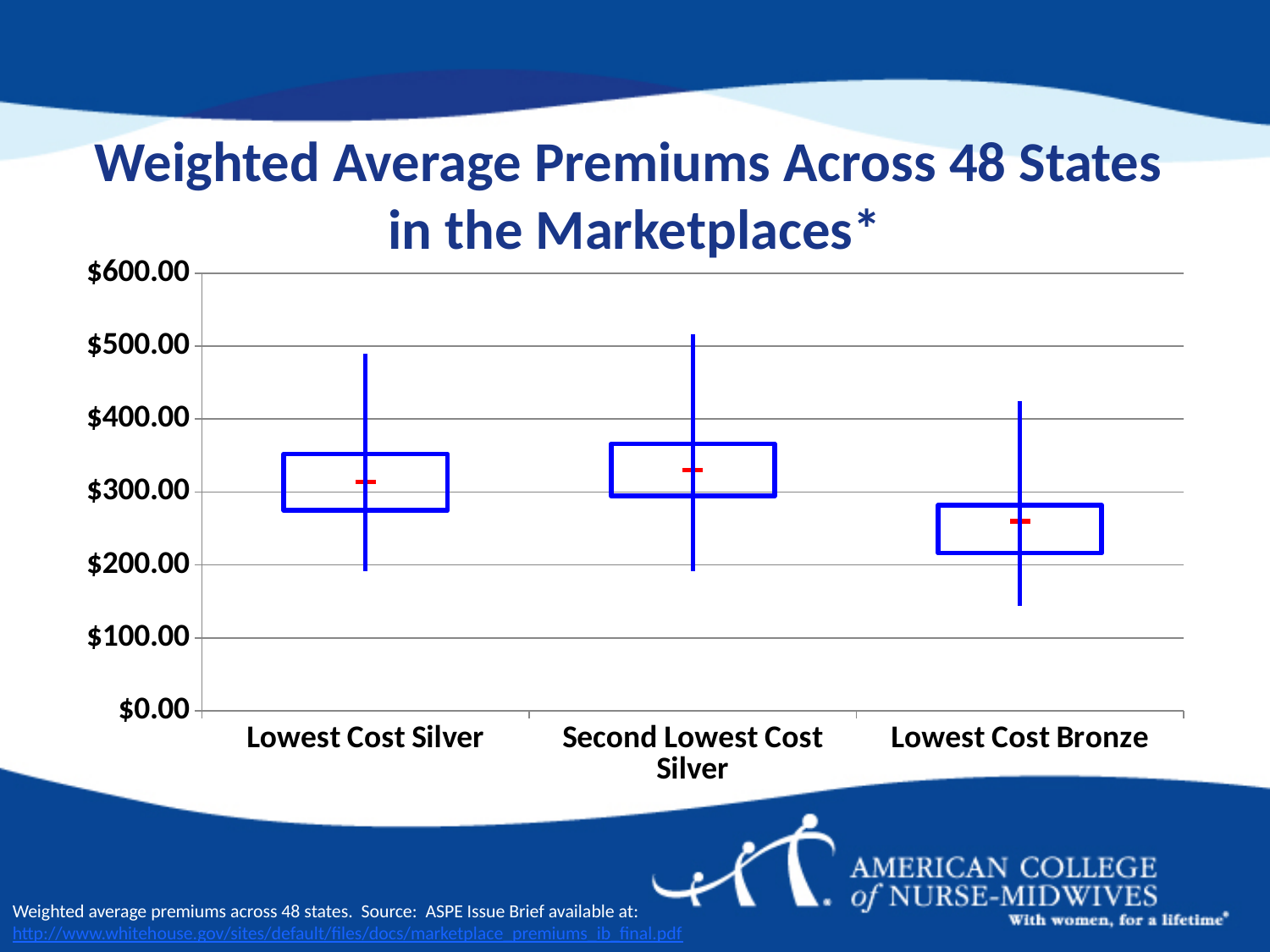
What is the title of the chart? Weighted Average Premiums Across 48 States in the Marketplaces* How many categories are shown on the x axis? 3 Is the red marker for Lowest Cost Bronze greater or less than $300.00? less Is the red marker for Lowest Cost Silver greater or less than $300.00? greater What kind of chart is shown on the slide? box-and-whisker (box plot) chart Is the top of the whisker for Lowest Cost Bronze greater or less than $400.00? greater Which category has a higher red marker, Lowest Cost Silver or Lowest Cost Bronze? Lowest Cost Silver What is the maximum value shown on the y axis? $600.00 Which category has the lowest red marker (central value)? Lowest Cost Bronze Which category has the highest red marker (central value)? Second Lowest Cost Silver